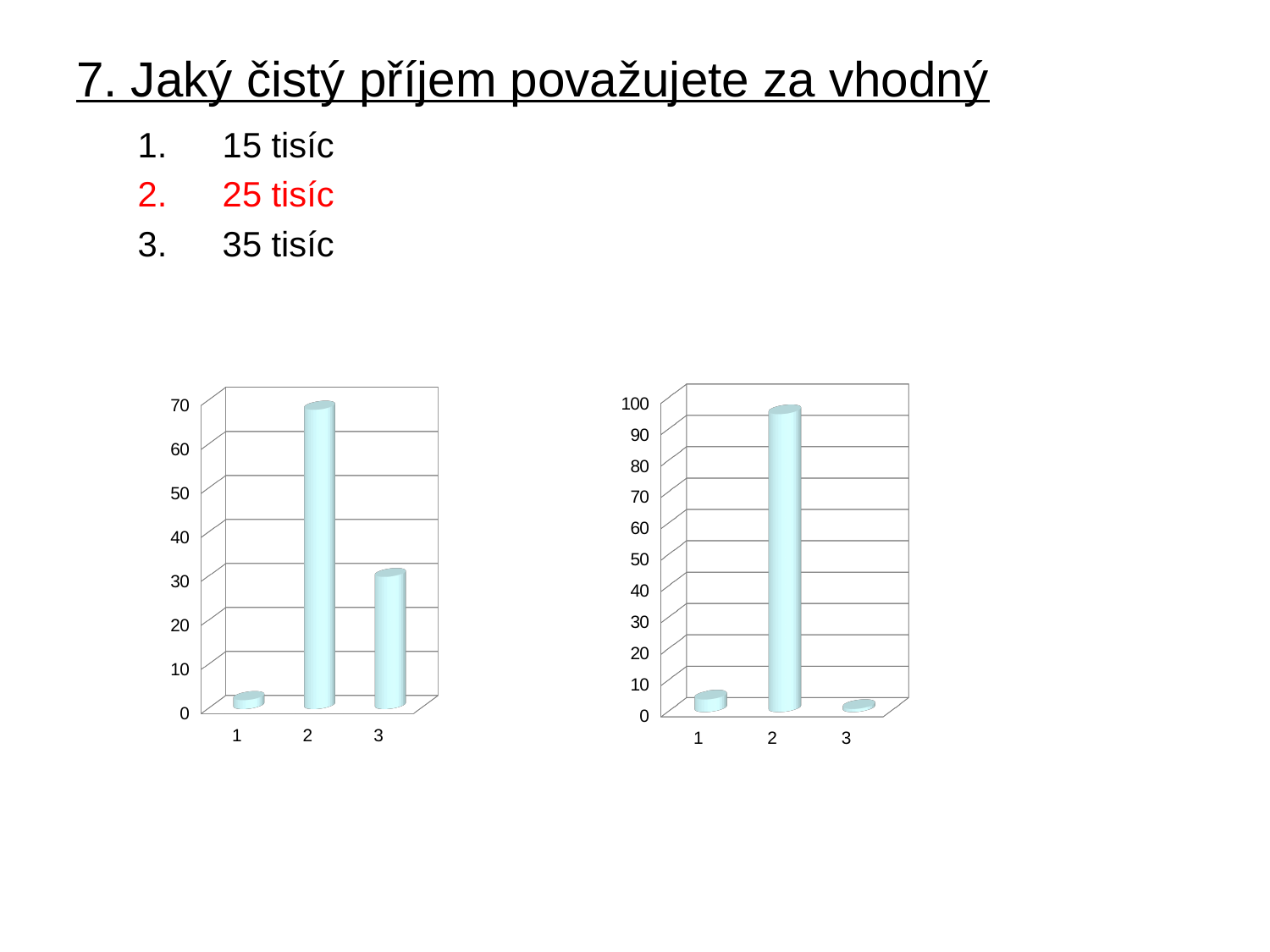
What kind of chart is the left chart on the slide? bar chart In the right chart, which category has the lowest bar? 3 In the right chart, is the value for category 2 greater or less than 90? greater In the left chart, which is larger, the value for category 3 or the value for category 1? category 3 In the left chart, is the value for category 2 greater or less than 60? greater In the right chart, which category has the highest bar? 2 In the right chart, is the value for category 1 greater or less than 10? less In the left chart, which category has the lowest bar? 1 How many categories does the right chart show on its x axis? 3 How many categories does the left chart show on its x axis? 3 In the left chart, which category has the highest bar? 2